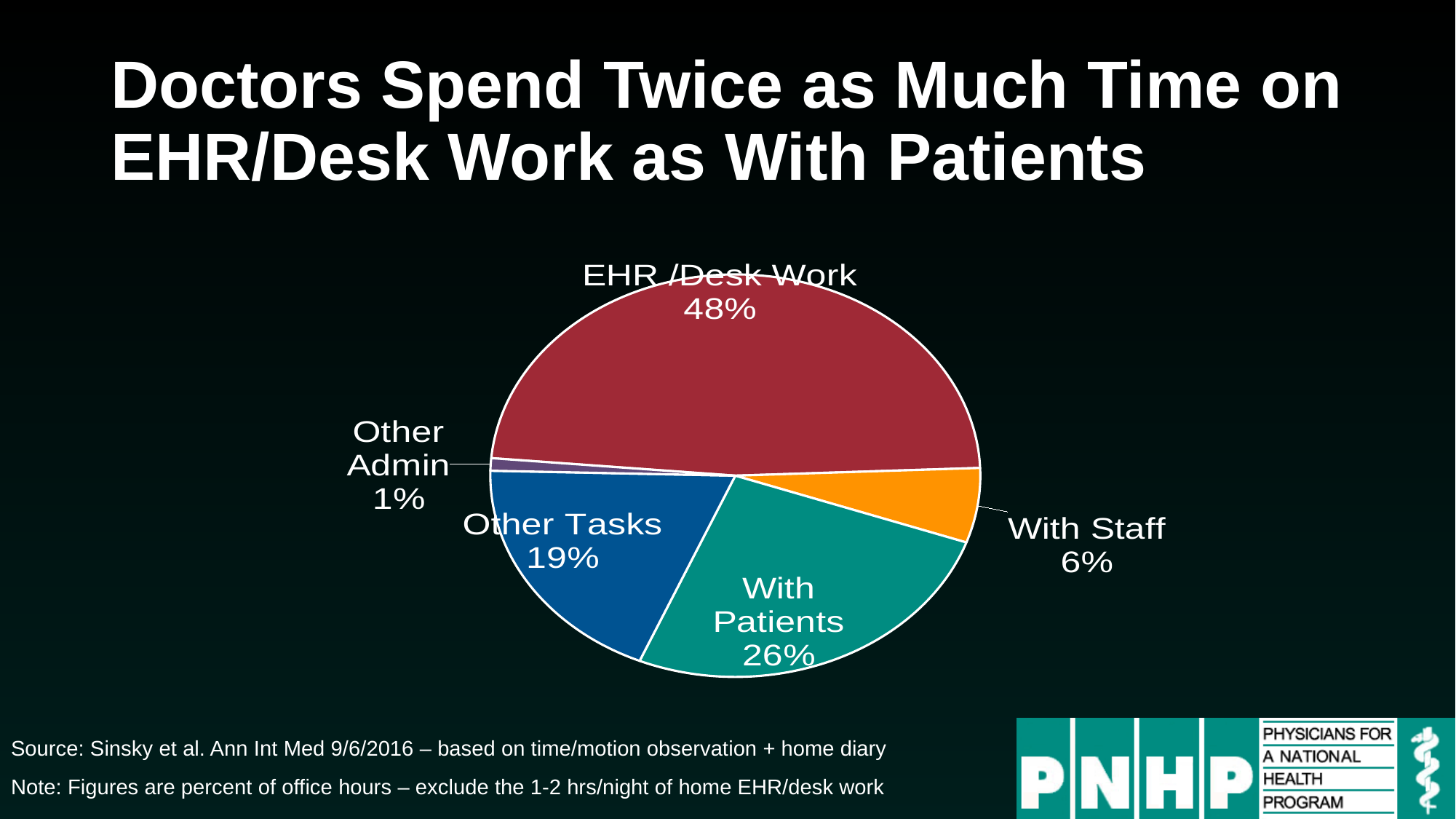
What percentage of office hours is spent on Other Admin? 1% What percentage of office hours is spent With Staff? 6% What percentage of office hours is spent With Patients? 26% Which is larger, the share for Other Tasks or the share for With Staff? Other Tasks How many categories are shown in the pie chart? 5 What percentage of office hours is spent on EHR/Desk Work? 48% What is the difference in percentage points between EHR/Desk Work and With Patients? 22 What colour is the EHR/Desk Work slice? red Which category takes the largest share of office hours? EHR/Desk Work What percentage of office hours is spent on Other Tasks? 19% Which category takes the smallest share of office hours? Other Admin What kind of chart is shown on the slide? pie chart